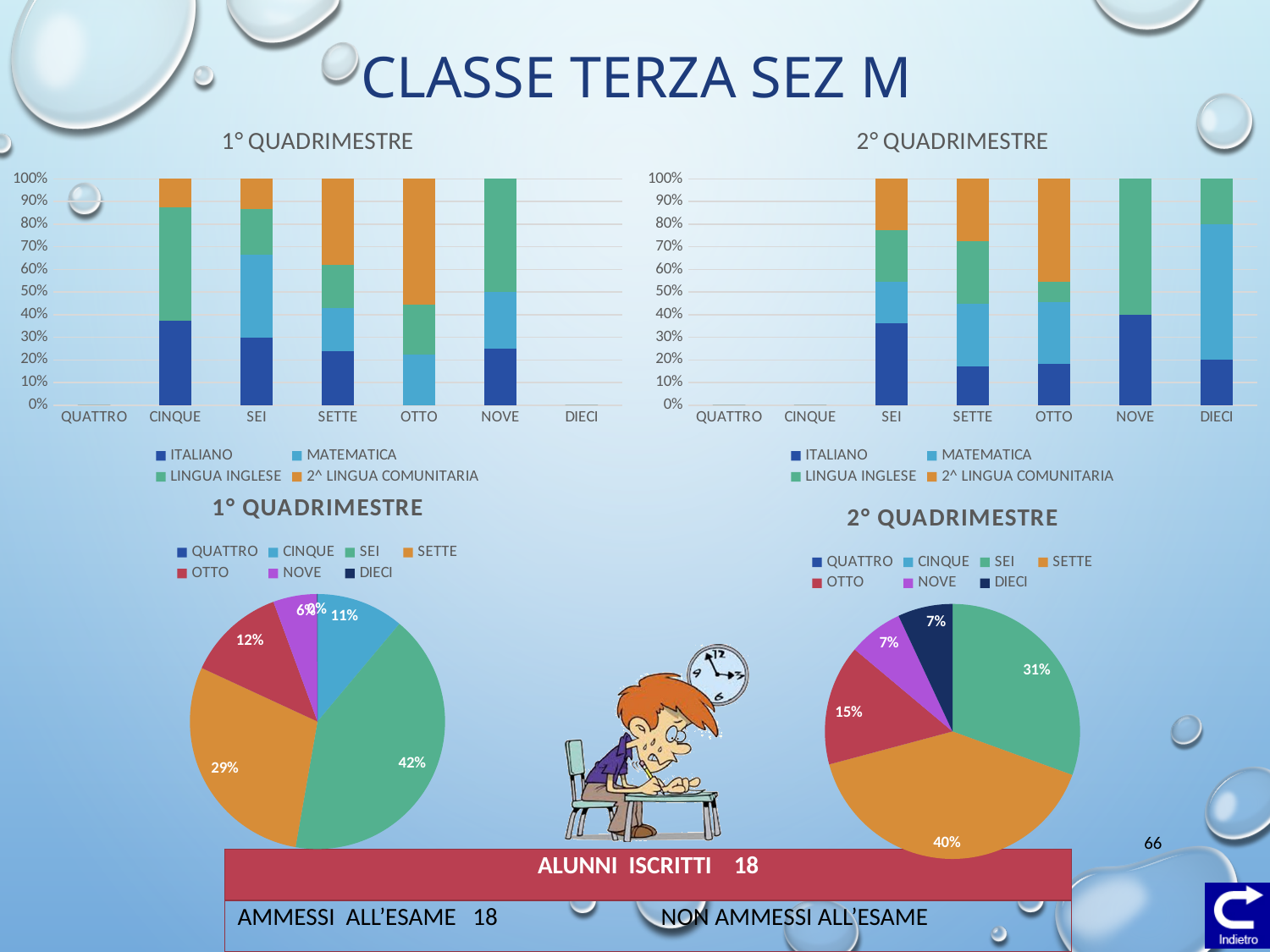
How many series does the legend of the 1° Quadrimestre stacked bar chart list? 4 In the 2° Quadrimestre stacked bar chart, is the ITALIANO value for NOVE greater or less than 30%? greater In the 2° Quadrimestre pie chart, what share does SETTE have? 40% In the 2° Quadrimestre pie chart, which is larger, the share of SEI or the share of OTTO? SEI In the 1° Quadrimestre pie chart, what share does SETTE have? 29% In the 1° Quadrimestre pie chart, what share does SEI have? 42% In the 2° Quadrimestre pie chart, what share does OTTO have? 15% In the 1° Quadrimestre stacked bar chart, is the ITALIANO value for OTTO greater or less than 30%? less In the 1° Quadrimestre pie chart, which category has the largest share? SEI In the 1° Quadrimestre pie chart, what is the difference between the shares of SEI and SETTE? 13% What kind of chart is the 2° Quadrimestre chart at the top right of the slide? Stacked bar chart In the 2° Quadrimestre pie chart, which category has the largest share? SETTE